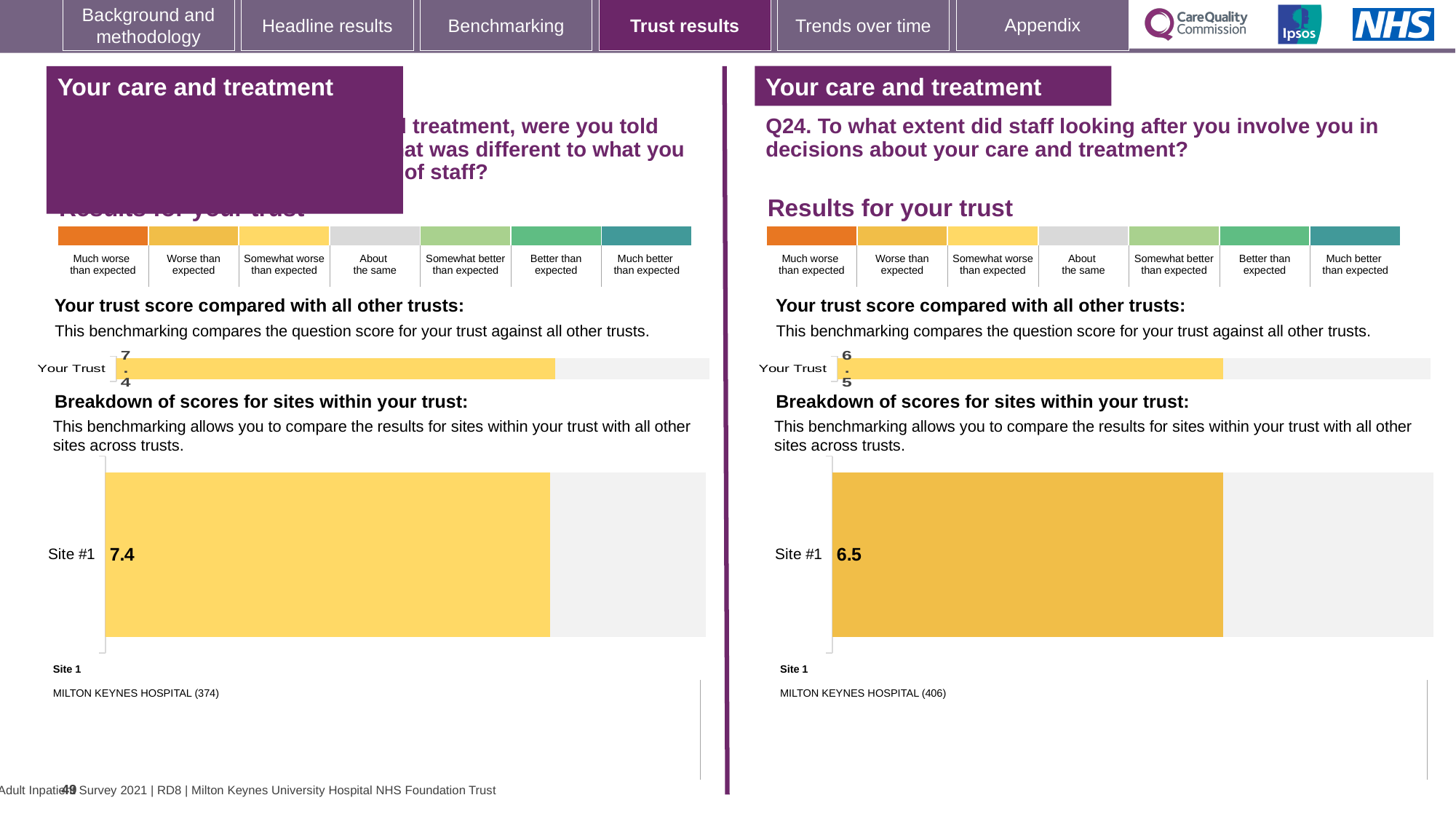
What type of chart is used to show the breakdown of scores for sites on the right-hand side of the slide? Bar chart On the left-hand chart, what is the score shown for Your Trust? 7.4 On the right-hand chart for Q24, what is the score shown for Site #1? 6.5 Is the Site #1 score on the right-hand chart for Q24 greater or less than the Site #1 score on the left-hand chart? less What is the difference between the Site #1 score on the left-hand chart and the Site #1 score on the right-hand chart for Q24? 0.9 On the left-hand chart, what is the score shown for Site #1? 7.4 On the right-hand chart for Q24, which site name is listed as Site 1? MILTON KEYNES HOSPITAL (406) How many sites are shown in the breakdown of scores on the right-hand chart for Q24? 1 On the right-hand chart for Q24, what is the score shown for Your Trust? 6.5 On the left-hand chart, which site name is listed as Site 1? MILTON KEYNES HOSPITAL (374) Which is larger: the Site #1 score on the left-hand chart or the Site #1 score on the right-hand chart for Q24? Left-hand chart (7.4) How many sites are shown in the breakdown of scores on the left-hand chart? 1